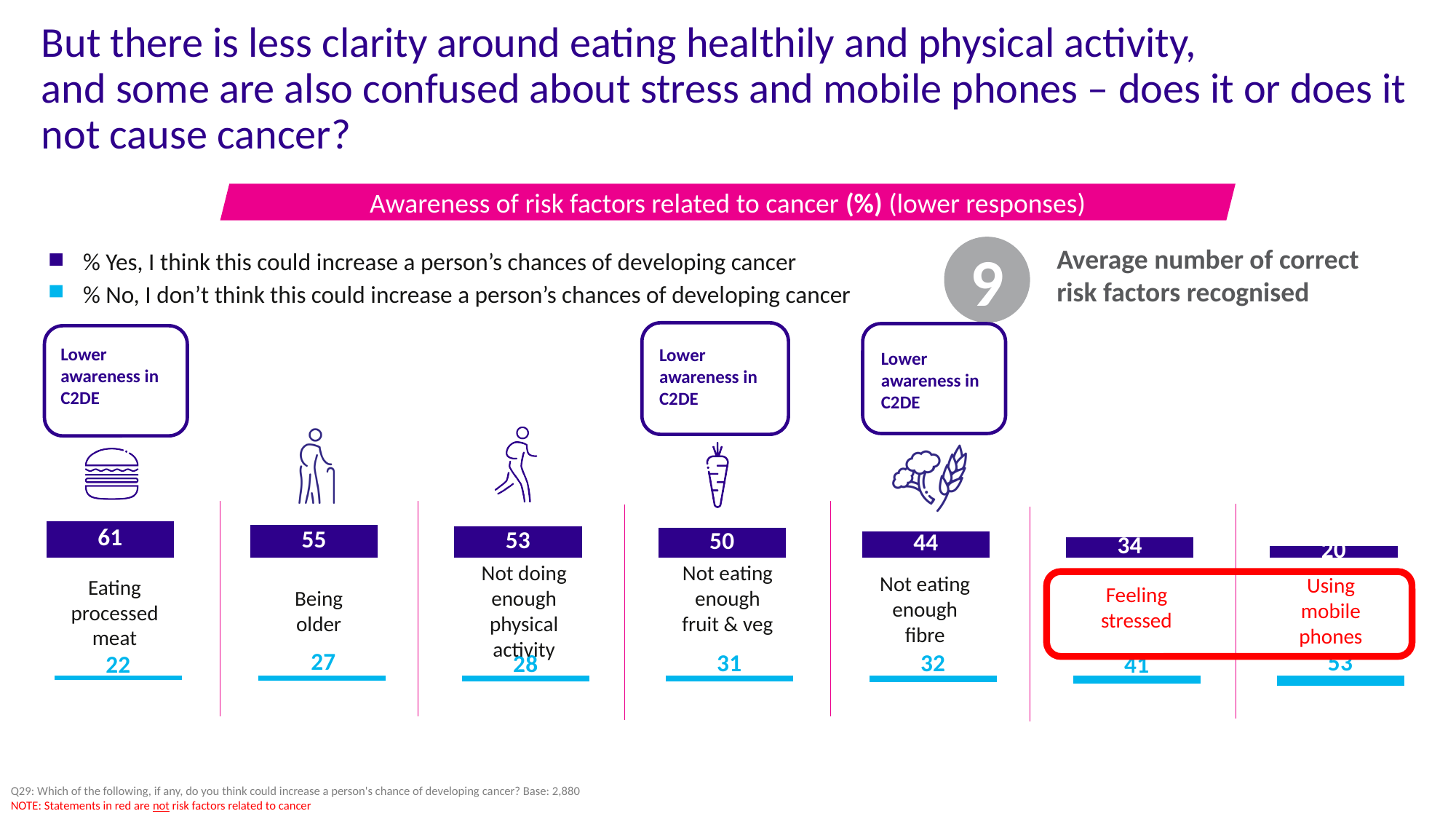
What percentage of respondents do not think being older could increase a person's chances of developing cancer? 27 How many risk factors are shown in the chart? 7 Which risk factor has the highest '% Yes' value? Eating processed meat Which two statements are highlighted in red as not being risk factors related to cancer? Feeling stressed and Using mobile phones How many series does the legend list? 2 What is the average number of correct risk factors recognised, as shown on the slide? 9 Which factor has the lowest '% No' value? Eating processed meat What is the '% Yes' value for not eating enough fibre? 44 Which is larger for feeling stressed: the '% Yes' value or the '% No' value? % No What is the '% No' value for feeling stressed? 41 What is the difference between the '% Yes' values for being older and not eating enough fruit & veg? 5 What percentage of respondents think eating processed meat could increase a person's chances of developing cancer? 61